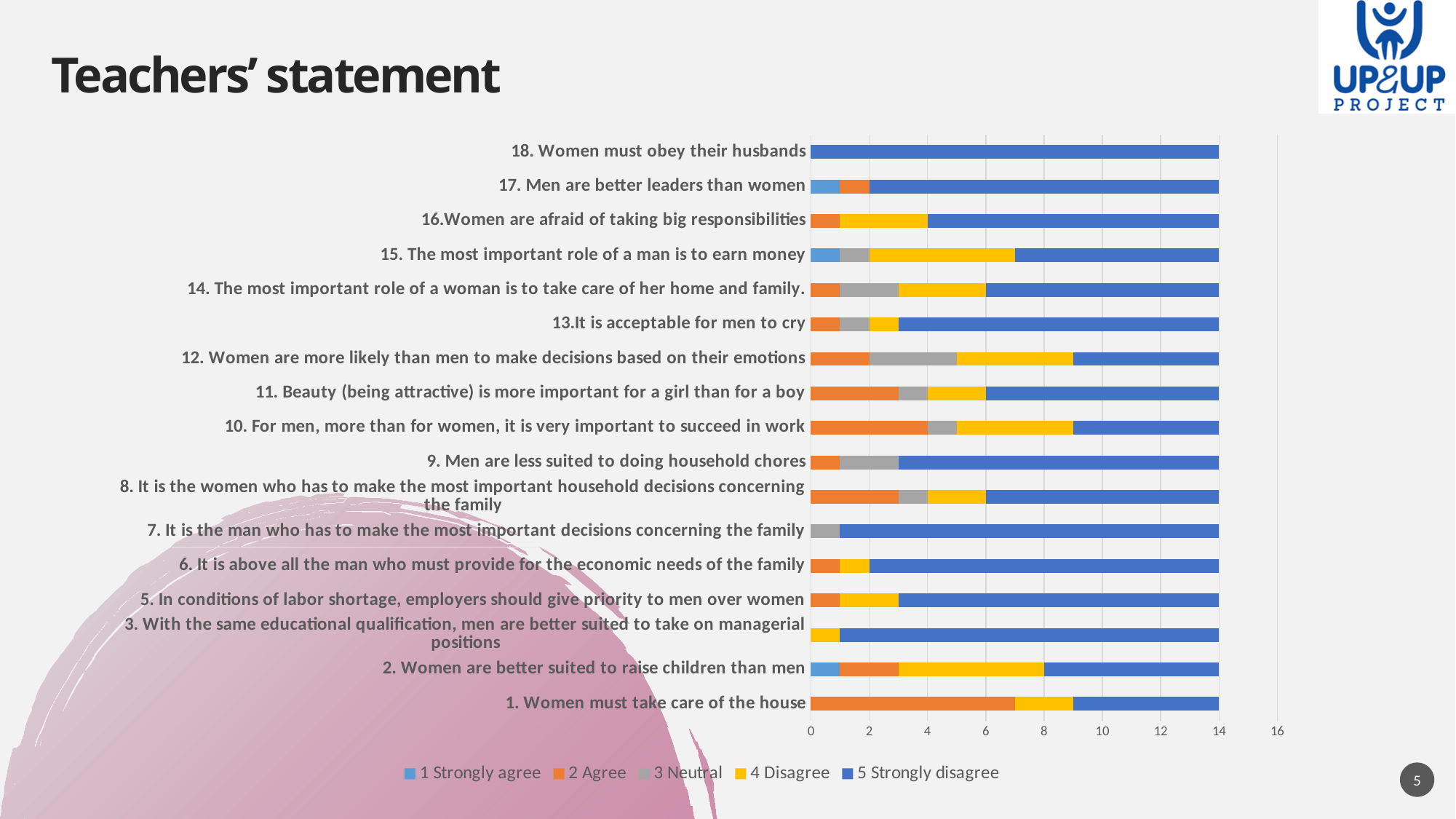
What kind of chart is shown on the slide? Stacked bar chart Is the '5 Strongly disagree' value for '7. It is the man who has to make the most important decisions concerning the family' greater or less than 12? greater Is the '4 Disagree' value for '13.It is acceptable for men to cry' greater or less than 2? less Is the '2 Agree' value for '1. Women must take care of the house' greater or less than 6? greater How many statements (categories) are plotted on the chart? 17 Which statement has the largest '2 Agree' segment? 1. Women must take care of the house What is the total length of the bar for '18. Women must obey their husbands'? 14 Which statement has the largest '5 Strongly disagree' segment? 18. Women must obey their husbands Which has the larger '2 Agree' segment: '1. Women must take care of the house' or '17. Men are better leaders than women'? 1. Women must take care of the house What is the title of the slide containing the chart? Teachers' statement Which legend entry is shown in dark blue? 5 Strongly disagree How many series does the legend list? 5